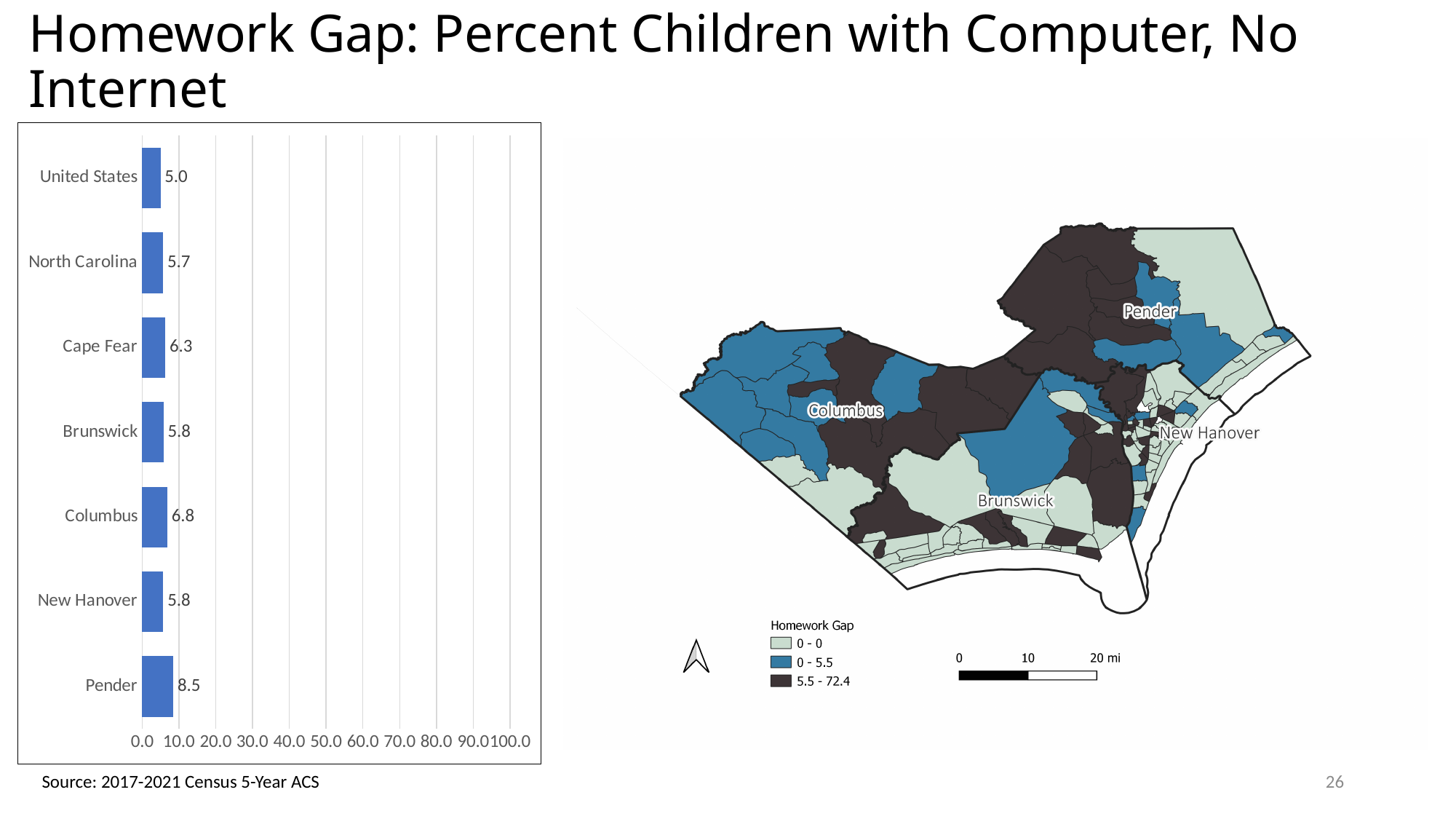
What kind of chart is shown on the left of the slide? bar chart In the bar chart, which is larger, the value for Columbus or the value for Cape Fear? Columbus In the bar chart, which category has the highest value? Pender In the bar chart, what is the difference between the values for Pender and United States? 3.5 In the bar chart, what is the value for North Carolina? 5.7 In the bar chart, what is the value for Columbus? 6.8 In the bar chart, what is the value for United States? 5.0 In the bar chart, which category has the lowest value? United States In the bar chart, what is the value for Pender? 8.5 In the bar chart, what is the difference between the values for Columbus and Cape Fear? 0.5 How many categories are shown in the bar chart? 7 In the bar chart, is the value for Pender greater or less than 10.0? less